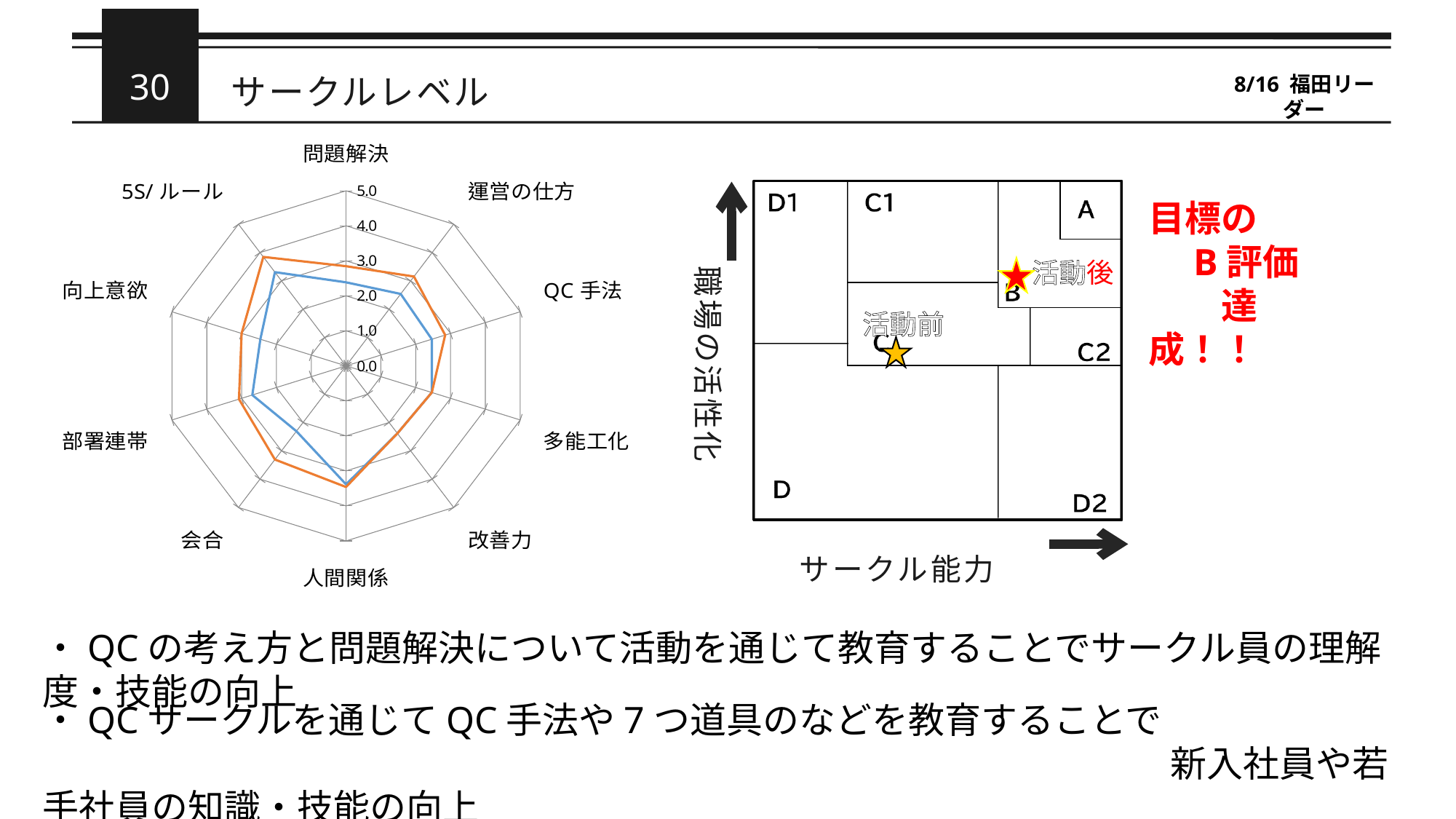
What kind of chart is shown on the left of the slide? radar chart On the radar chart, is the orange line's value for 5S/ルール greater or less than 3.0? greater On the radar chart, is the blue line's value for 人間関係 greater or less than 3.0? greater On the radar chart, is the orange line's value for 会合 greater or less than 3.0? greater What is the maximum tick value shown on the radar chart's scale? 5.0 In the matrix diagram on the right, which cell does the 活動後 star fall in? B On the radar chart, for 5S/ルール, which line has the larger value, the orange line or the blue line? orange line How many data series are plotted on the radar chart? 2 On the radar chart, which category has the highest value for the orange line? 5S/ルール How many categories (axes) does the radar chart have? 10